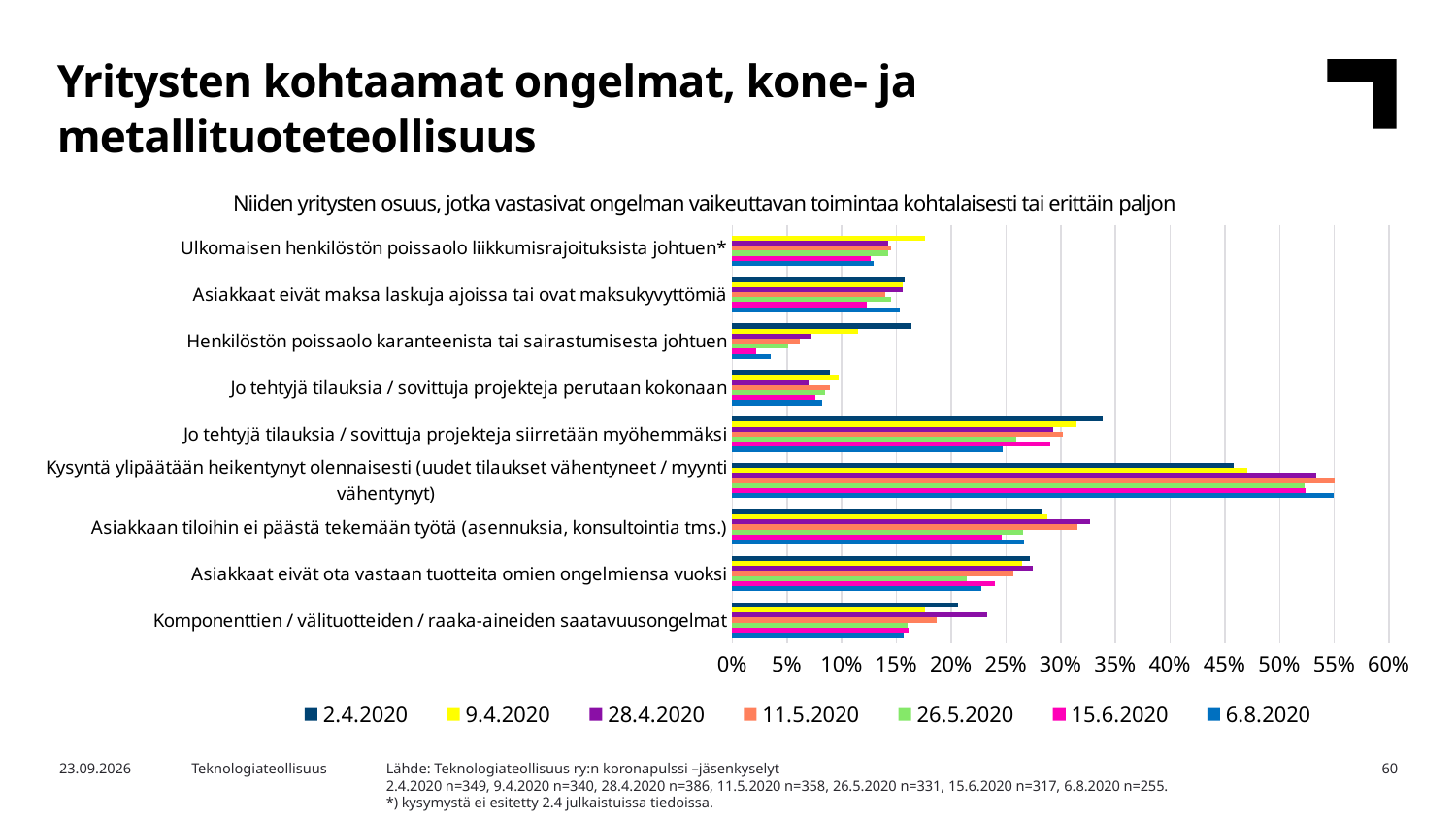
How many problem categories are listed on the chart's vertical axis? 9 For the 6.8.2020 series, which category has the lowest value? Henkilöstön poissaolo karanteenista tai sairastumisesta johtuen What is the title of the chart? Niiden yritysten osuus, jotka vastasivat ongelman vaikeuttavan toimintaa kohtalaisesti tai erittäin paljon For 'Henkilöstön poissaolo karanteenista tai sairastumisesta johtuen', which is larger: the 2.4.2020 value or the 6.8.2020 value? 2.4.2020 What is the last series listed in the legend? 6.8.2020 For 'Kysyntä ylipäätään heikentynyt olennaisesti', which is larger: the 2.4.2020 value or the 6.8.2020 value? 6.8.2020 Which category has the highest values across all survey dates? Kysyntä ylipäätään heikentynyt olennaisesti (uudet tilaukset vähentyneet / myynti vähentynyt) How many series (survey dates) does the legend list? 7 What kind of chart is shown on the slide? Bar chart Is the 6.8.2020 value for 'Henkilöstön poissaolo karanteenista tai sairastumisesta johtuen' greater or less than 5%? less Is the 2.4.2020 value for 'Jo tehtyjä tilauksia / sovittuja projekteja siirretään myöhemmäksi' greater or less than 30%? greater Is the 6.8.2020 value for 'Kysyntä ylipäätään heikentynyt olennaisesti' greater or less than 50%? greater